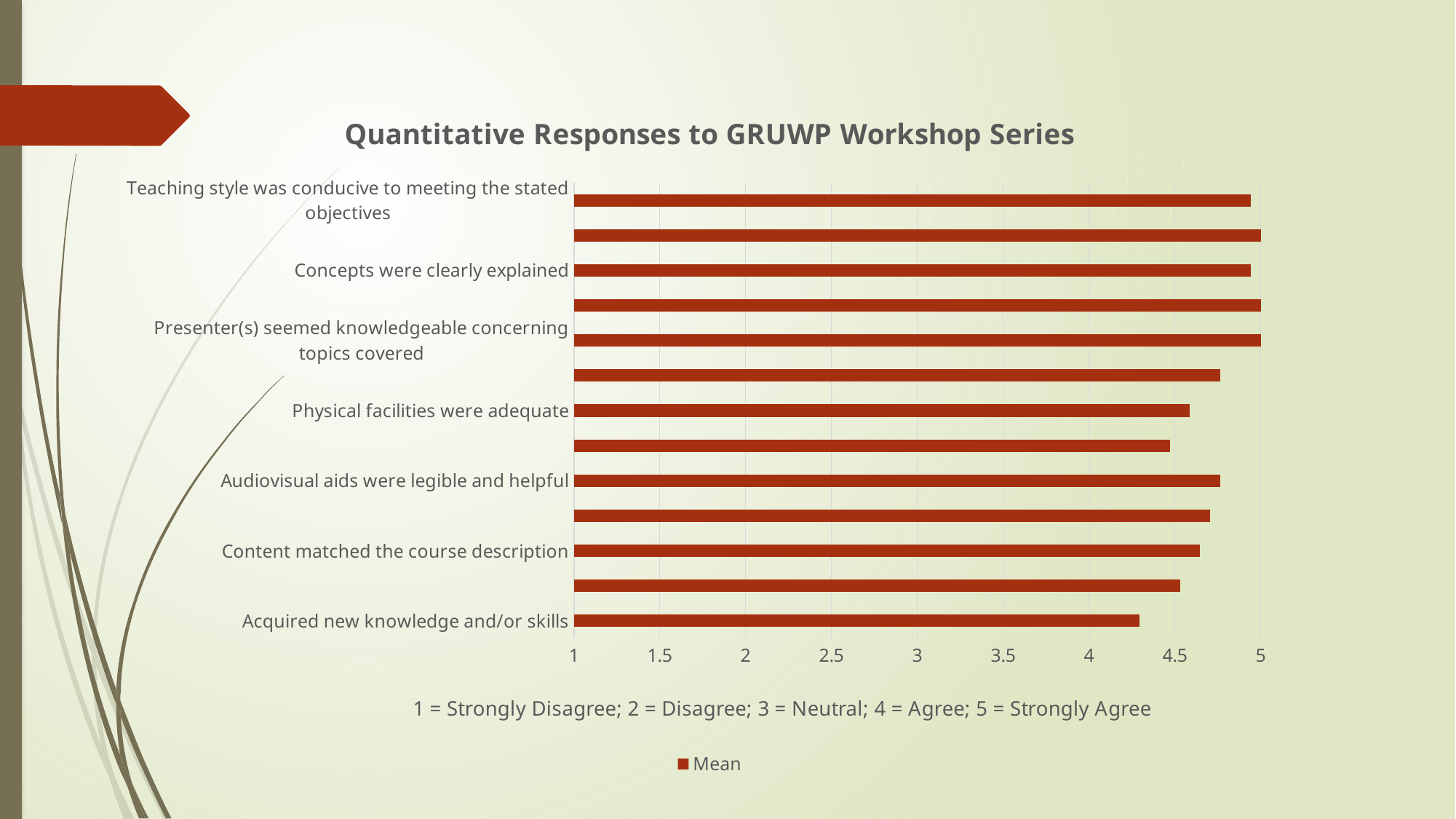
Is the value for 'Concepts were clearly explained' greater or less than 4? greater How many bars are plotted in the chart? 13 Which is larger, the value for 'Audiovisual aids were legible and helpful' or the value for 'Acquired new knowledge and/or skills'? Audiovisual aids were legible and helpful Which is larger, the value for 'Presenter(s) seemed knowledgeable concerning topics covered' or the value for 'Physical facilities were adequate'? Presenter(s) seemed knowledgeable concerning topics covered What kind of chart is shown on the slide? bar chart Is the value for 'Teaching style was conducive to meeting the stated objectives' greater or less than 4.5? greater Is the value for 'Acquired new knowledge and/or skills' greater or less than 4.5? less How many series does the legend list? 1 Which labelled category has the lowest mean value? Acquired new knowledge and/or skills What is the name of the series shown in the legend? Mean What is the title of the chart? Quantitative Responses to GRUWP Workshop Series